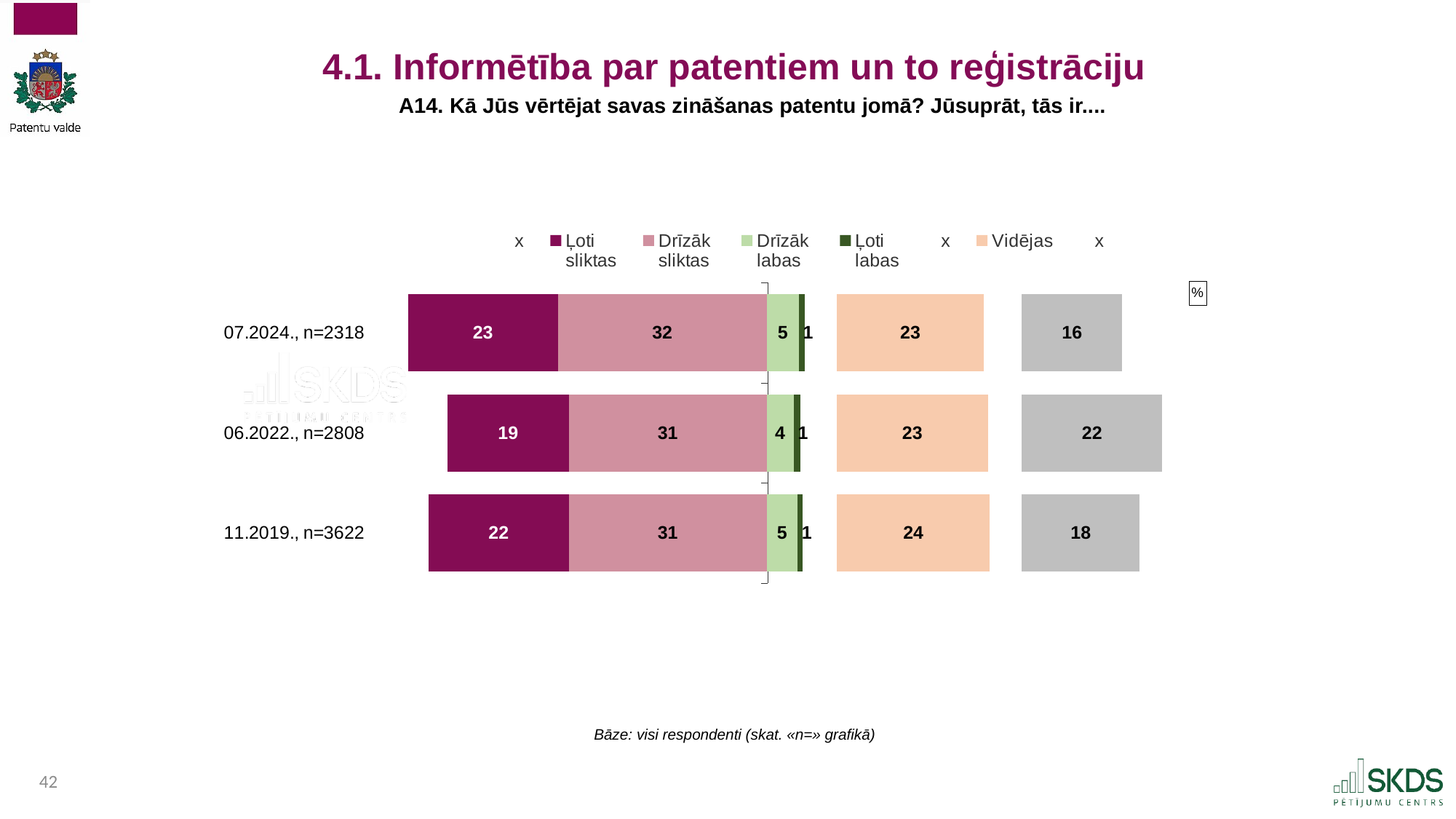
What is the value for "Drīzāk labas" in the 06.2022., n=2808 row? 4 What is the value for "Drīzāk sliktas" in the 06.2022., n=2808 row? 31 Which survey wave has the highest value for "Ļoti sliktas"? 07.2024., n=2318 Which is larger: the "Vidējas" value for 11.2019., n=3622 or for 07.2024., n=2318? 11.2019., n=3622 What is the value for "Ļoti sliktas" in the 07.2024., n=2318 row? 23 What is the value for "Vidējas" in the 11.2019., n=3622 row? 24 What is the combined value of "Ļoti sliktas" and "Drīzāk sliktas" for 07.2024., n=2318? 55 What kind of chart is shown on the slide? Stacked bar chart Which legend entry is shown in the darkest purple colour? Ļoti sliktas Which survey wave has the lowest value for "Ļoti sliktas"? 06.2022., n=2808 What is the difference between the "Drīzāk sliktas" values for 07.2024., n=2318 and 11.2019., n=3622? 1 How many survey waves (rows) are shown in the chart? 3